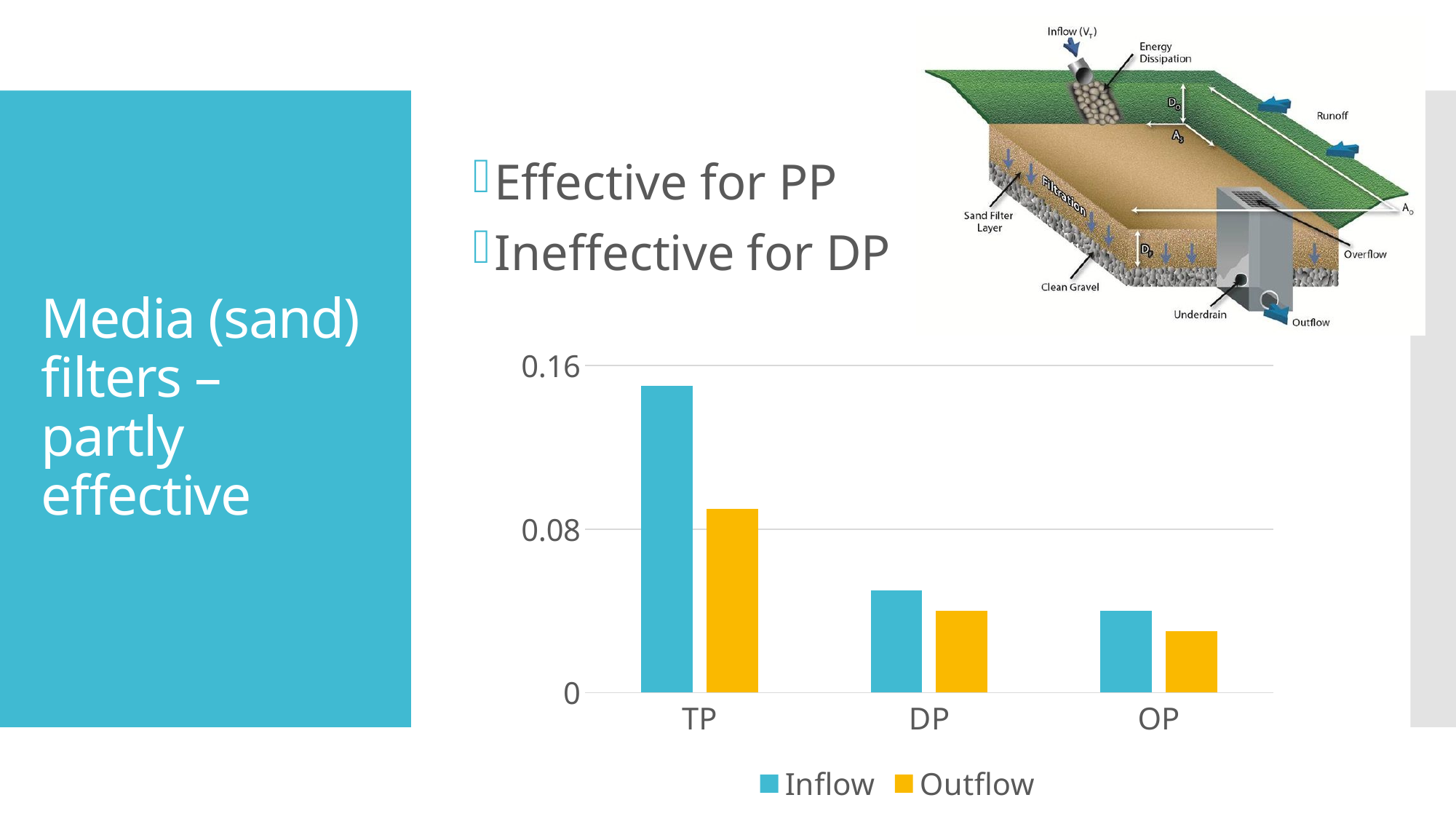
Is the Inflow value for DP greater or less than 0.08? less How many categories are shown on the x axis of the chart? 3 Do the Inflow values rise or fall from TP to OP along the x axis? fall What kind of chart is shown on the slide? bar chart Is the Inflow value for TP greater or less than 0.08? greater How many series does the chart's legend list? 2 Is the Inflow value for TP greater or less than 0.16? less For TP, which is larger, the Inflow or the Outflow value? Inflow Which category has the lowest Outflow value? OP What colour are the Outflow bars in the chart? yellow Which category has the highest Inflow value? TP